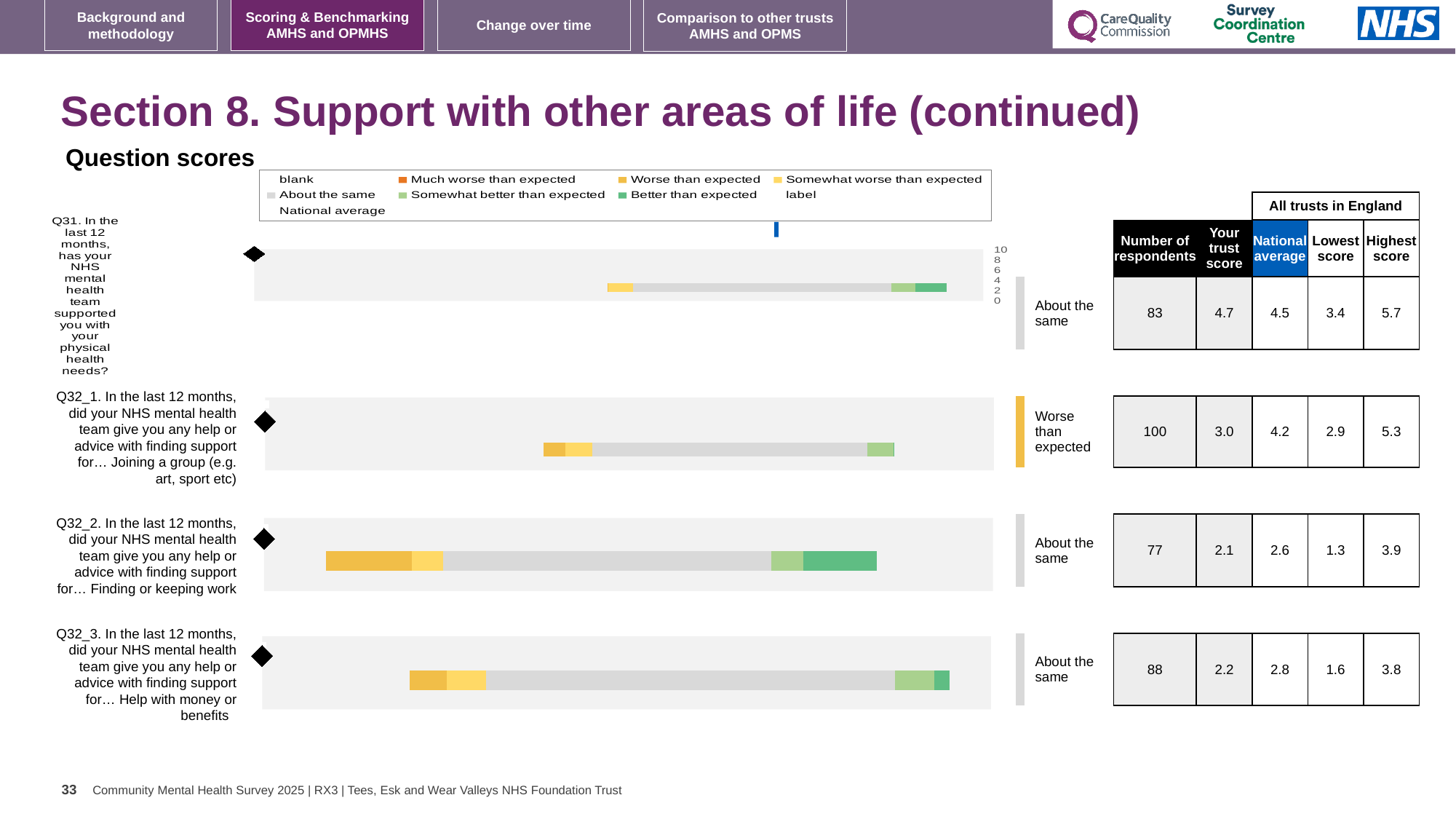
How many respondents are shown for Q32_2 (finding or keeping work)? 77 What is the national average for Q32_1 (help with joining a group)? 4.2 What is the highest score among all trusts in England for Q32_3 (help with money or benefits)? 3.8 Which question has the lowest 'Your trust score'? Q32_2 Which question has the highest 'Your trust score'? Q31 Which benchmark category is Q32_1 (joining a group) rated as? Worse than expected How many of the four questions are rated 'About the same'? 3 What is the difference between the highest score and the lowest score for Q31? 2.3 How many questions have a bar plotted in the question scores chart? 4 What is the 'Your trust score' value for Q31 (support with physical health needs)? 4.7 For Q32_1, is the trust score higher or lower than the national average? Lower What kind of chart is used to show the question scores on this slide? Bar chart